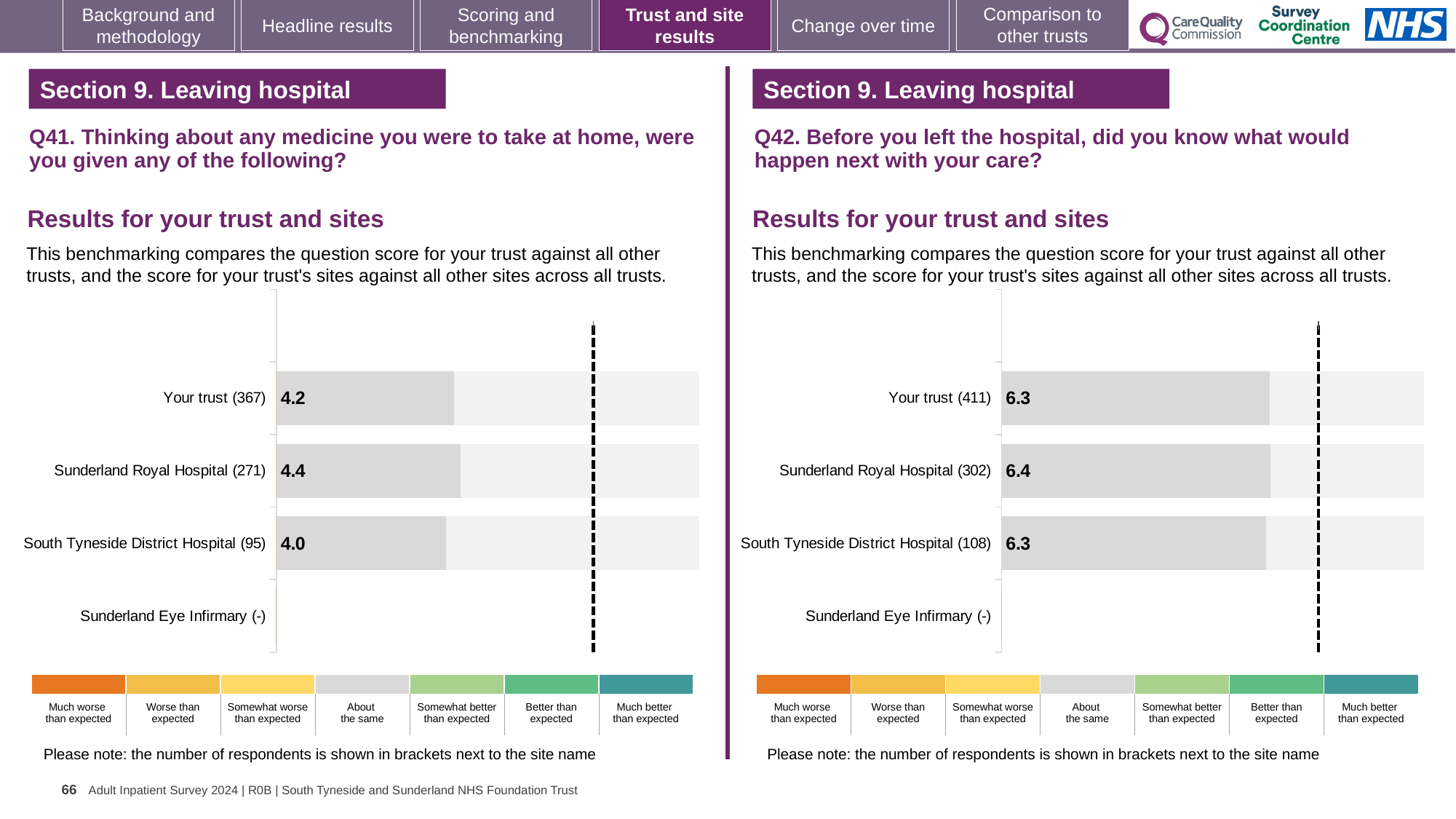
In the Q42 chart on the right, how many respondents are shown in brackets for Your trust? 411 In the Q41 chart on the left, how many site rows are listed, including Your trust? 4 In the Q42 chart on the right, what is the score for Your trust? 6.3 In the Q41 chart on the left, what is the score for South Tyneside District Hospital? 4.0 What kind of chart is used in the Q41 chart on the left? Bar chart In the Q41 chart on the left, what is the difference between the scores for Sunderland Royal Hospital and South Tyneside District Hospital? 0.4 In the Q41 chart on the left, what is the score for Sunderland Royal Hospital? 4.4 In the Q42 chart on the right, which is larger: the score for Sunderland Royal Hospital or the score for Your trust? Sunderland Royal Hospital In the Q42 chart on the right, what is the score for Sunderland Royal Hospital? 6.4 In the Q41 chart on the left, what is the score for Your trust? 4.2 In the Q41 chart on the left, which site has the highest score? Sunderland Royal Hospital In the Q42 chart on the right, what is the score for South Tyneside District Hospital? 6.3